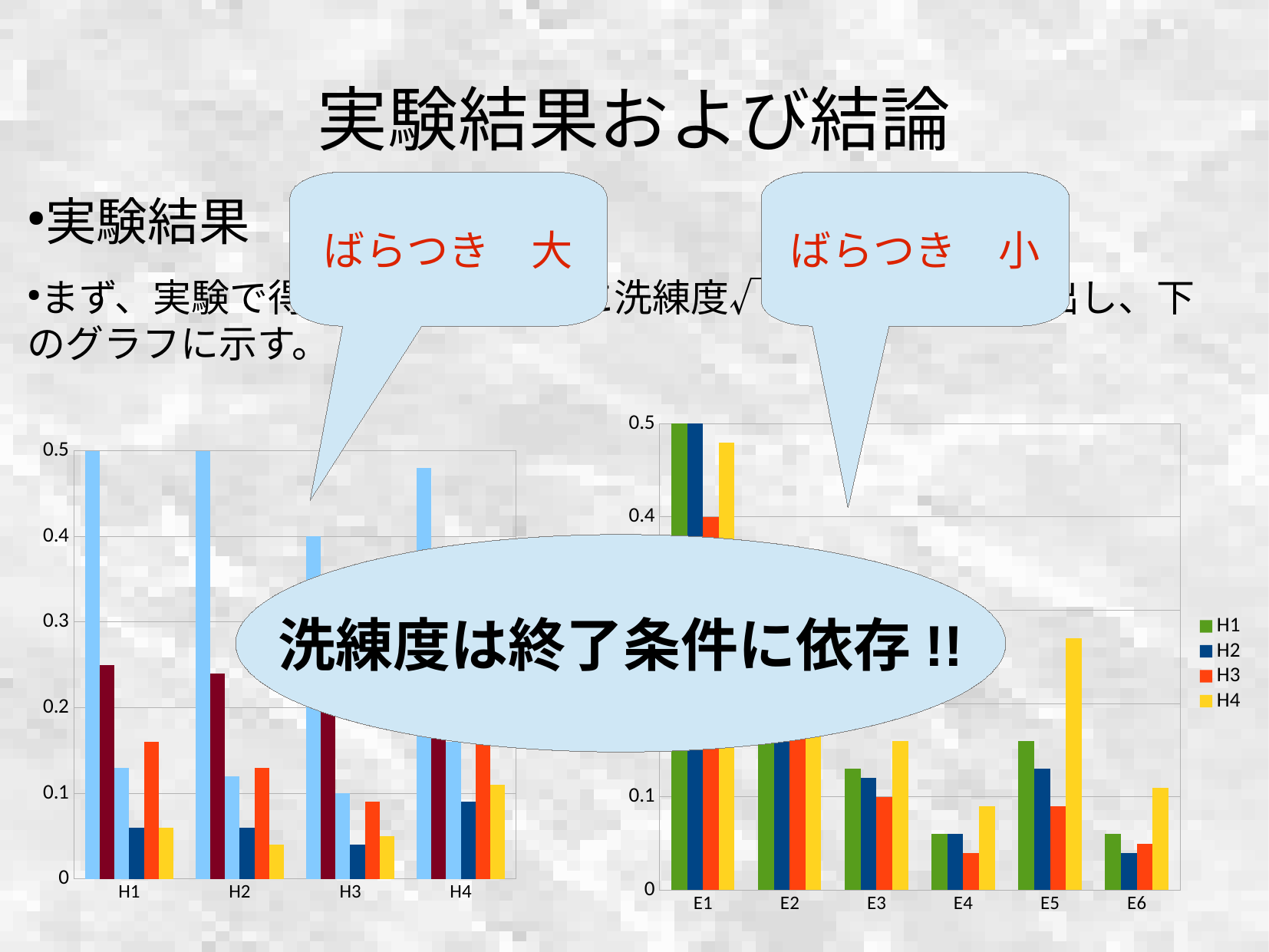
How many series does the legend of the right chart list? 4 In the right chart, is the value of H3 for E4 greater or less than 0.1? less In the right chart, which series has the highest value for E5? H4 How many categories are shown on the x axis of the left chart (H1 to H4)? 4 In the right chart, what is the value of H1 for E1? 0.5 What kind of chart is the chart on the right (categories E1 to E6)? bar chart In the right chart, what is the value of H3 for E1? 0.4 How many categories are shown on the x axis of the right chart (E1 to E6)? 6 In the right chart, is the value of H4 for E5 greater or less than 0.2? greater In the right chart, which is larger for E1: H3 or H4? H4 In the right chart, which series has the lowest value for E4? H3 In the left chart, is the tallest bar for H4 greater or less than 0.4? greater